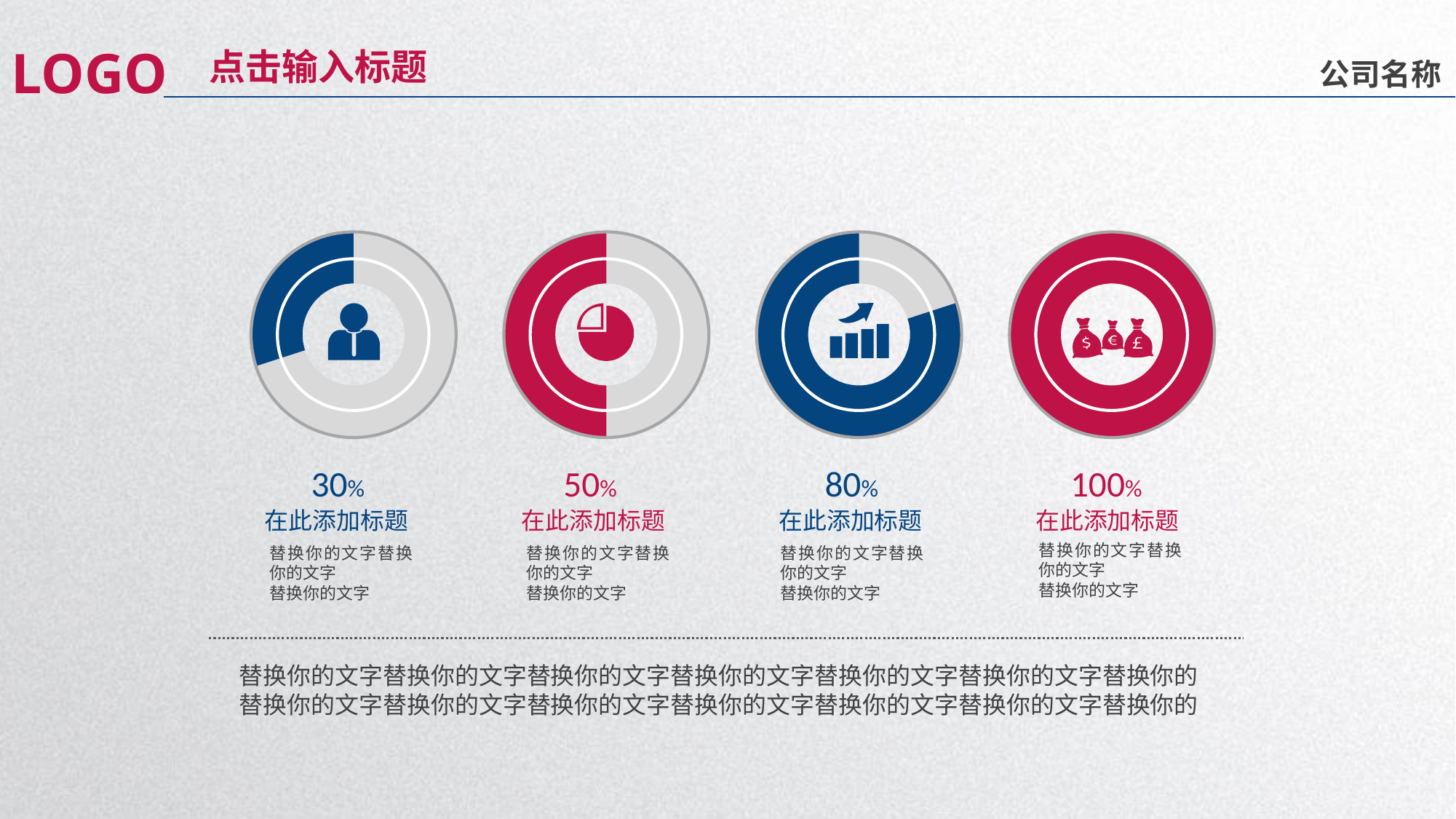
What percentage is shown below the third ring chart with the bar-and-arrow icon? 80% How many ring charts are shown on the slide? 4 Which is larger, the percentage of the second ring chart or the third ring chart? The third ring chart (80%) What percentage is shown below the first (leftmost) ring chart with the person icon? 30% What is the difference between the percentage of the fourth ring chart and the second ring chart? 50% Do the percentages increase or decrease from the leftmost chart to the rightmost chart? Increase Which of the four ring charts shows the highest percentage? The fourth (rightmost) chart, 100% What is the difference between the percentage of the third ring chart and the first ring chart? 50% What colour is the filled portion of the ring chart showing 80%? Blue What percentage is shown below the second ring chart with the pie icon? 50% What percentage is shown below the fourth (rightmost) ring chart with the money bags icon? 100% Which of the four ring charts shows the lowest percentage? The first (leftmost) chart, 30%